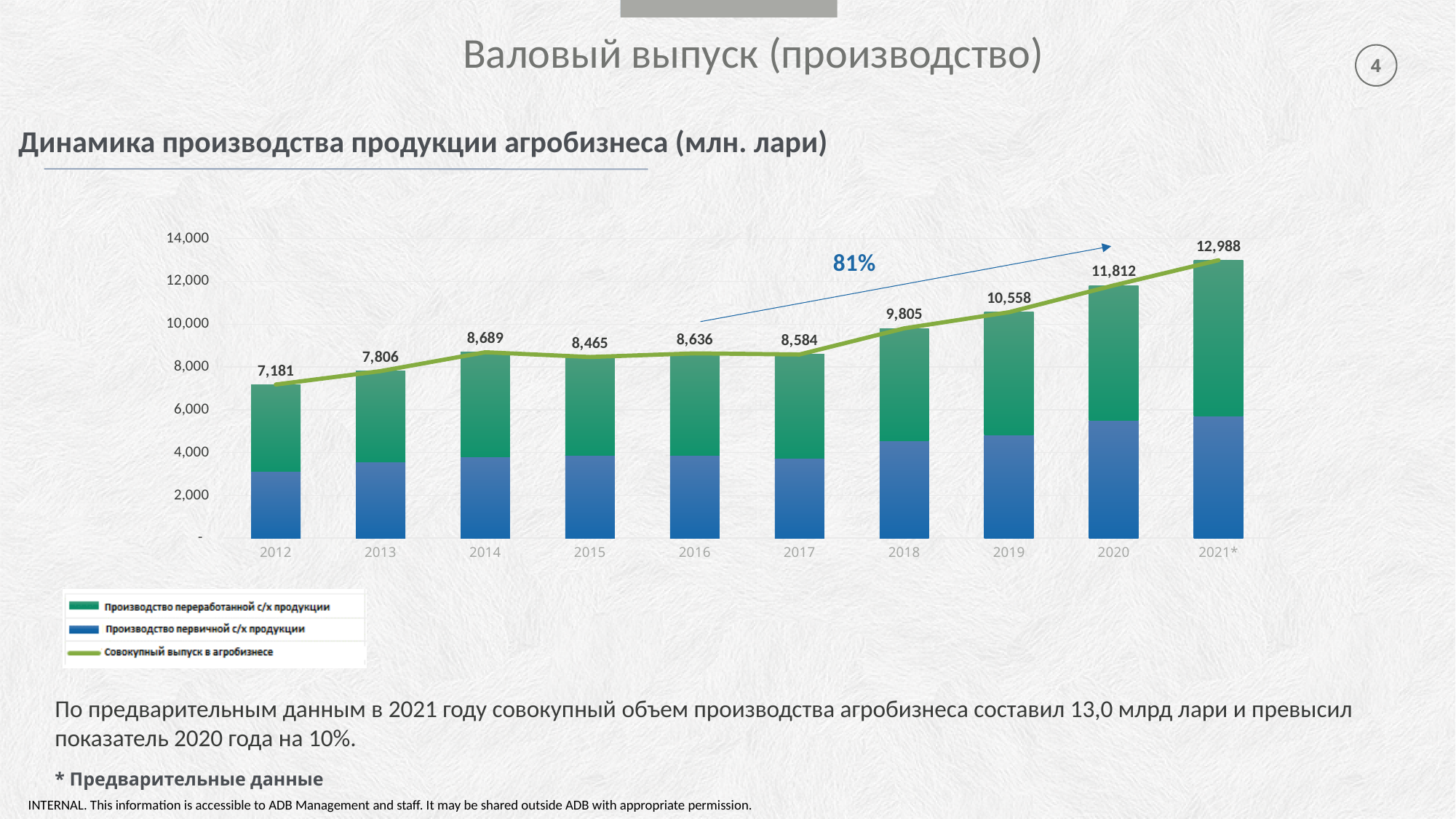
How many series does the legend list? 3 How many years are shown on the x axis of the chart? 10 Which year has the lowest total agribusiness output? 2012 Which year has the larger total value, 2015 or 2016? 2016 Is the value of the blue segment (Производство первичной с/х продукции) for 2020 greater or less than 4,000? greater What is the total agribusiness output value shown for 2021*? 12,988 Which year has the highest total agribusiness output? 2021* What is the difference between the total values for 2021* and 2020? 1,176 Is the value of the blue segment (Производство первичной с/х продукции) for 2012 greater or less than 4,000? less What percentage growth is annotated by the arrow on the chart? 81% What is the difference between the total values for 2020 and 2012? 4,631 What is the total value labelled above the bar for 2015? 8,465